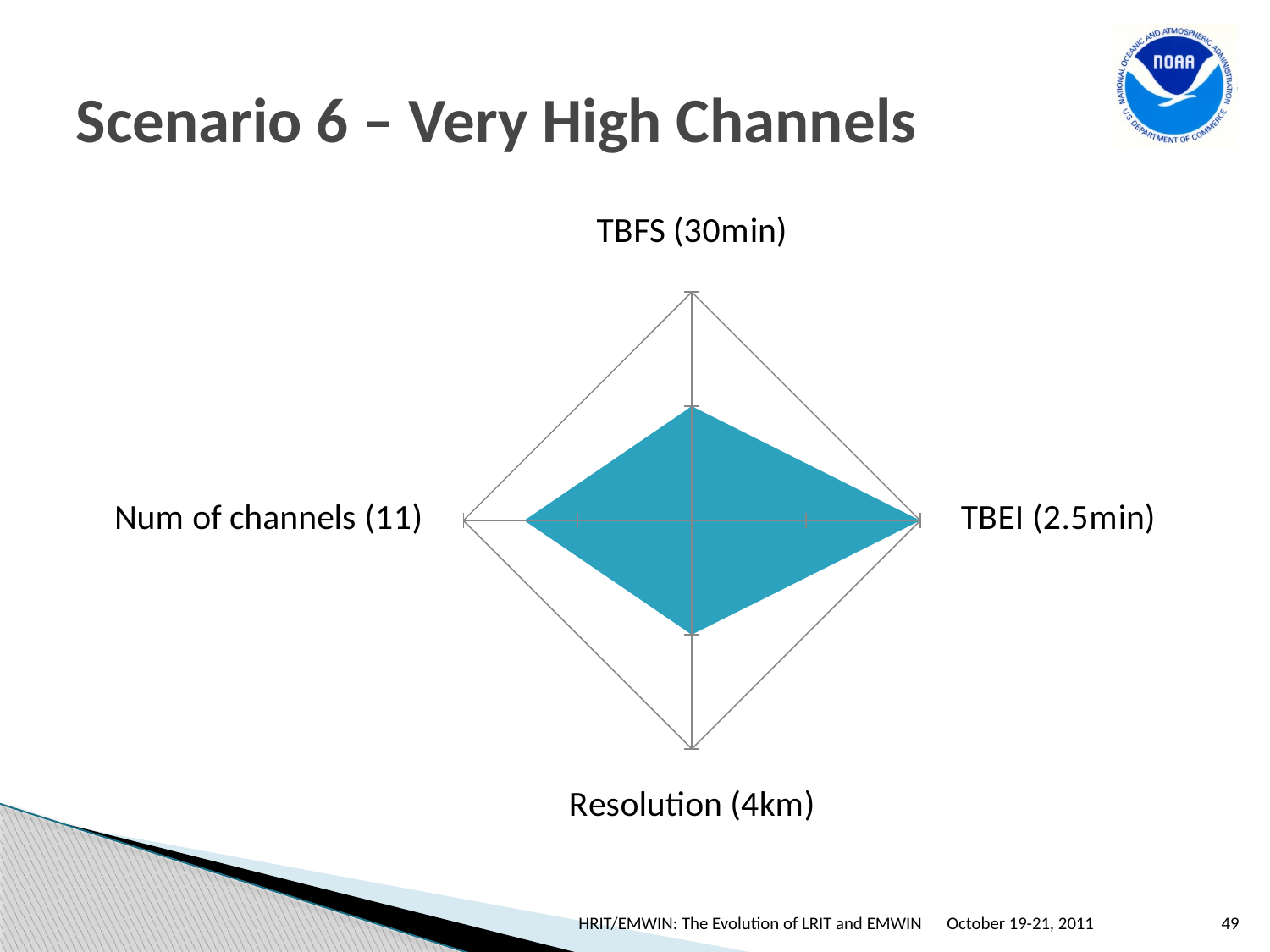
Which is larger on the radar chart, the value for Num of channels (11) or the value for Resolution (4km)? Num of channels (11) How many axes (categories) does the radar chart have? 4 Which is larger on the radar chart, the value for Num of channels (11) or the value for TBFS (30min)? Num of channels (11) What kind of chart is shown on the slide? Radar chart Which is larger on the radar chart, the value for TBEI (2.5min) or the value for Resolution (4km)? TBEI (2.5min) Which category label appears at the top of the radar chart? TBFS (30min) Which category label appears at the bottom of the radar chart? Resolution (4km) What is the title of the slide containing the radar chart? Scenario 6 – Very High Channels